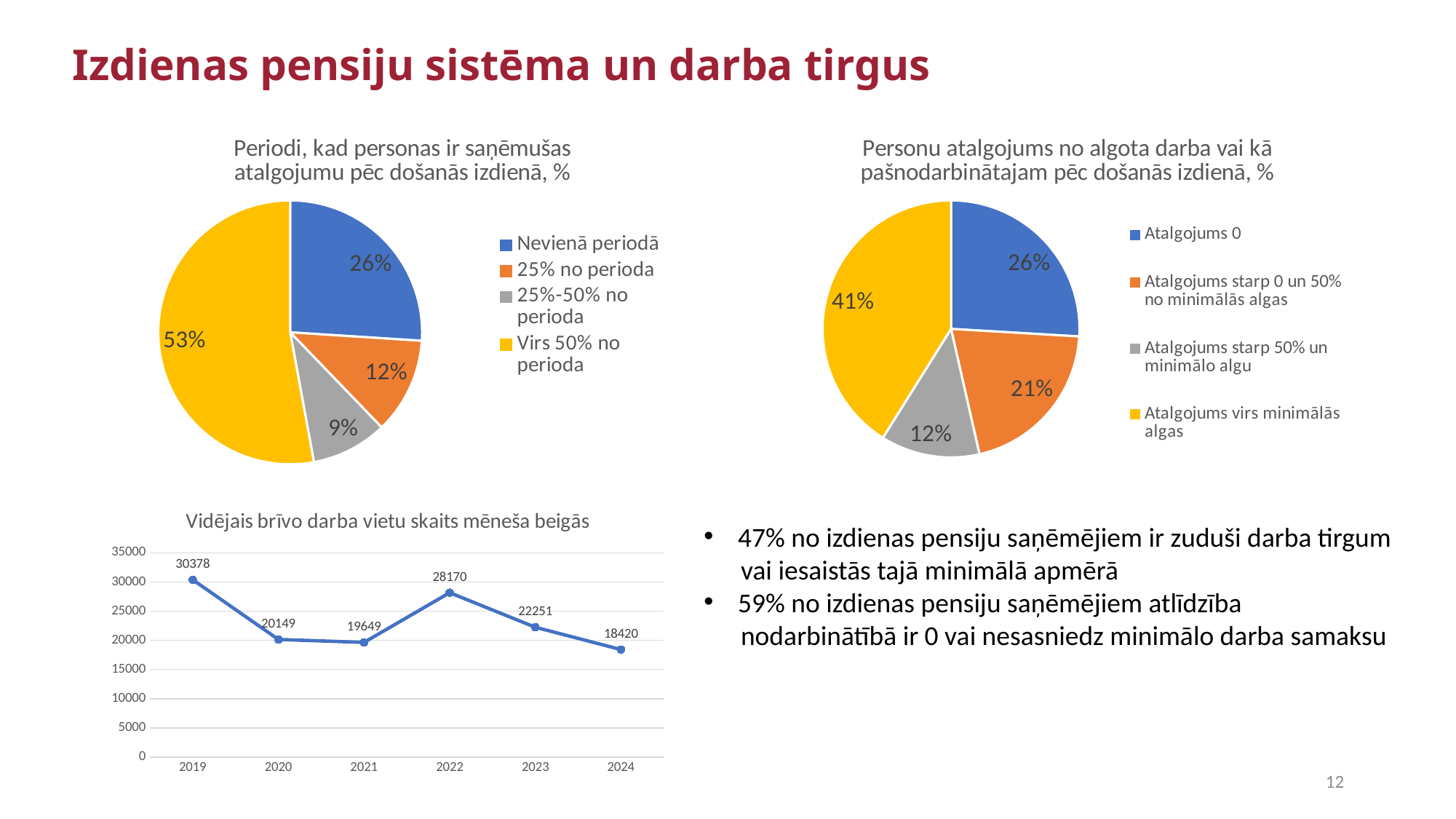
In the pie chart 'Periodi, kad personas ir saņēmušas atalgojumu pēc došanās izdienā, %', what share is 'Nevienā periodā'? 26% In the chart 'Vidējais brīvo darba vietu skaits mēneša beigās', which year has the lowest value? 2024 In the pie chart 'Periodi, kad personas ir saņēmušas atalgojumu pēc došanās izdienā, %', which category has the smallest share? 25%-50% no perioda In the pie chart 'Personu atalgojums no algota darba vai kā pašnodarbinātajam pēc došanās izdienā, %', what share is 'Atalgojums starp 0 un 50% no minimālās algas'? 21% In the chart 'Vidējais brīvo darba vietu skaits mēneša beigās', what is the value for 2022? 28170 In the pie chart 'Periodi, kad personas ir saņēmušas atalgojumu pēc došanās izdienā, %', what share is 'Virs 50% no perioda'? 53% In the pie chart 'Personu atalgojums no algota darba vai kā pašnodarbinātajam pēc došanās izdienā, %', which category has the largest share? Atalgojums virs minimālās algas What kind of chart is 'Vidējais brīvo darba vietu skaits mēneša beigās'? line chart In the chart 'Vidējais brīvo darba vietu skaits mēneša beigās', what is the difference between the values for 2019 and 2024? 11958 In the pie chart 'Personu atalgojums no algota darba vai kā pašnodarbinātajam pēc došanās izdienā, %', how many categories does the legend list? 4 In the chart 'Vidējais brīvo darba vietu skaits mēneša beigās', is the value for 2023 greater or less than 20000? greater In the chart 'Vidējais brīvo darba vietu skaits mēneša beigās', what is the value for 2019? 30378